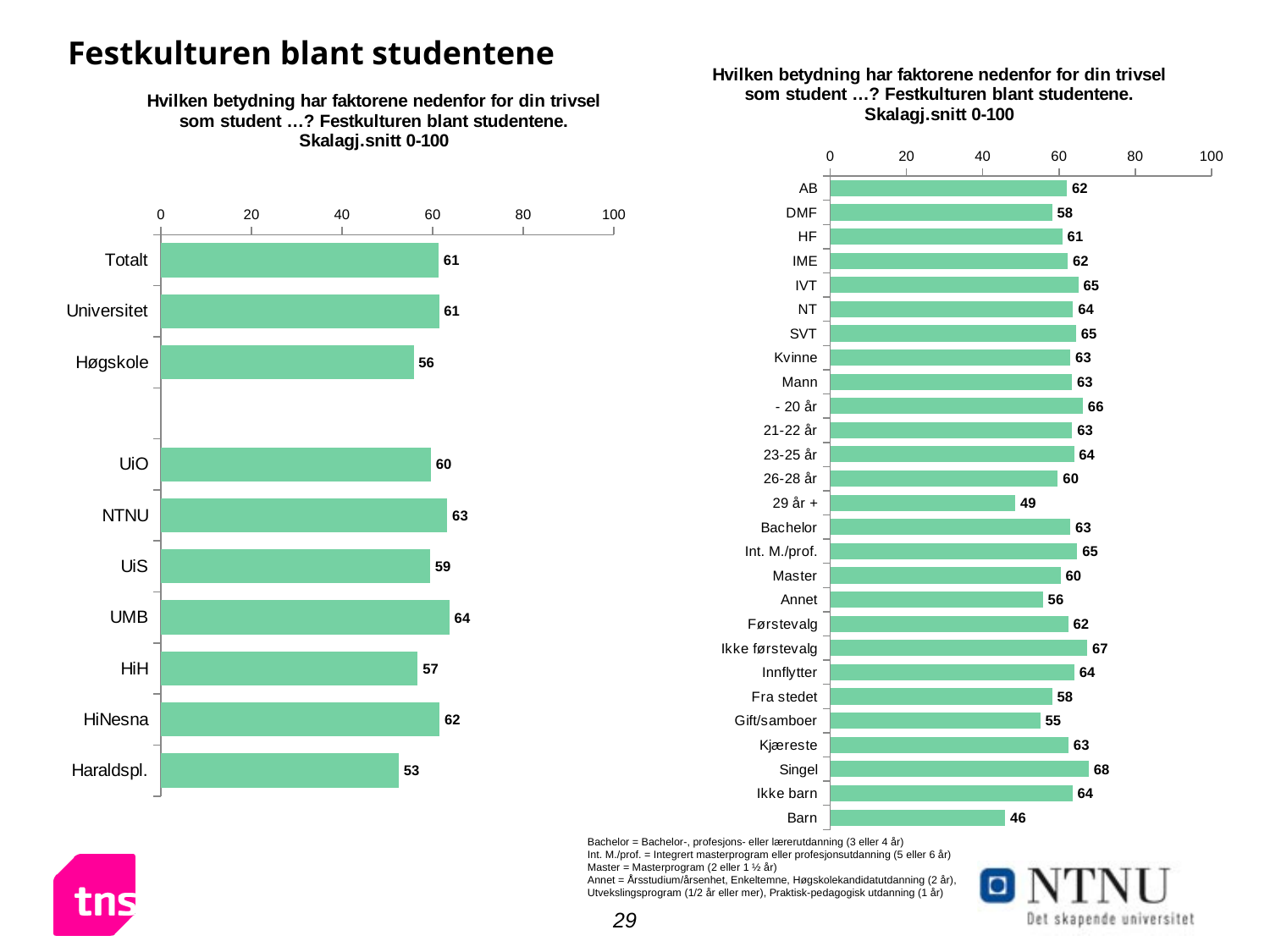
On the left chart, what is the value for UMB? 64 On the left chart, how many categories are plotted? 10 On the right chart, what is the value for Barn? 46 On the right chart, which category has the lowest value? Barn What kind of chart is the left chart? Bar chart On the right chart, which category has the highest value? Singel On the left chart, which category has the lowest value? Haraldspl. On the left chart, which category has the highest value? UMB On the right chart, how many categories are plotted? 27 On the right chart, which is larger, the value for Ikke førstevalg or the value for Førstevalg? Ikke førstevalg On the right chart, what is the difference between the values for Singel and Gift/samboer? 13 On the left chart, what is the difference between the values for NTNU and Høgskole? 7